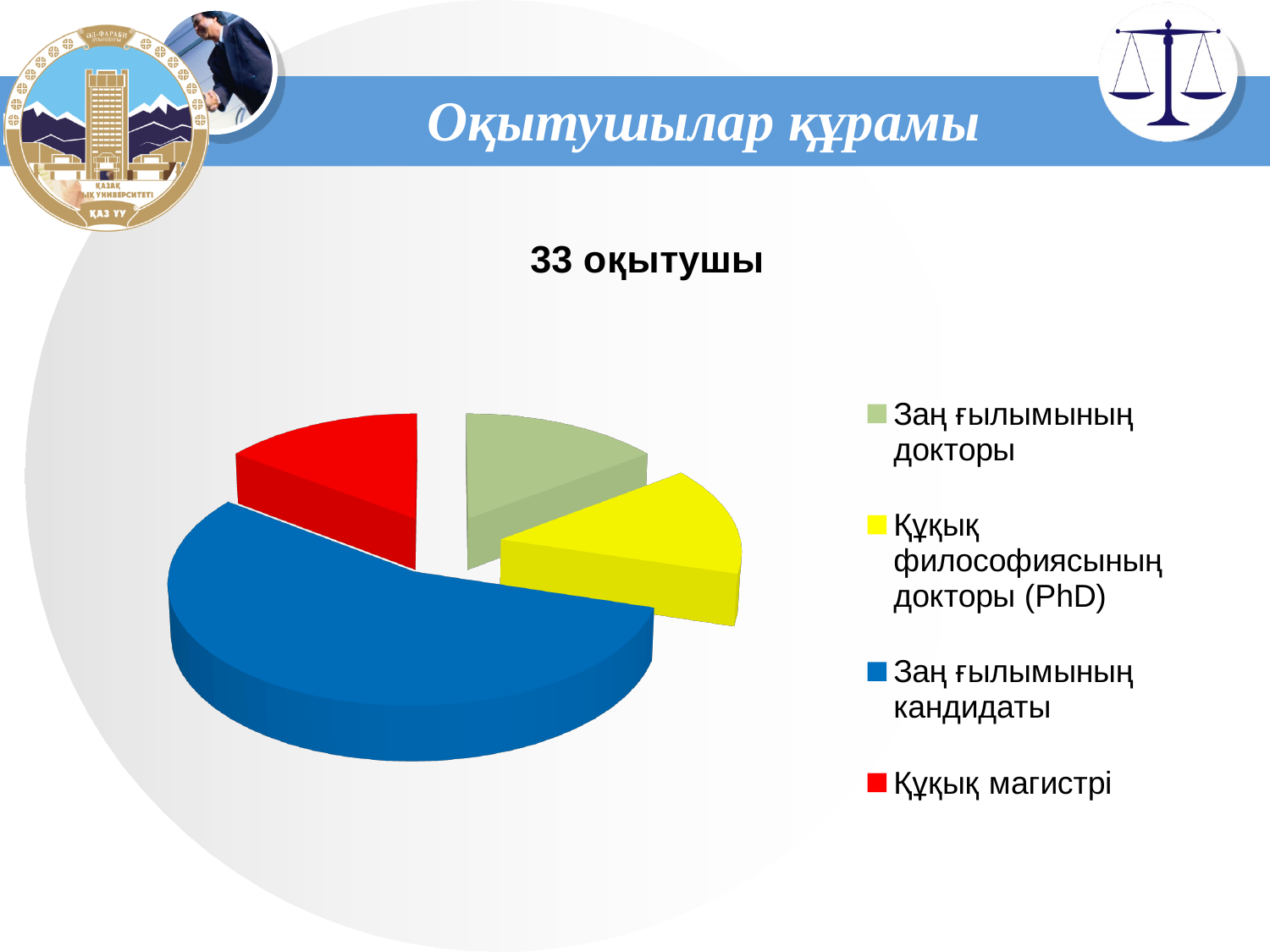
Which slice is larger: Заң ғылымының кандидаты or Құқық философиясының докторы (PhD)? Заң ғылымының кандидаты How many entries does the chart legend list? 4 Which slice is larger: Заң ғылымының кандидаты or Құқық магистрі? Заң ғылымының кандидаты How many slices does the pie chart have? 4 What kind of chart is shown on the slide? pie chart Which category has the largest slice of the pie chart? Заң ғылымының кандидаты What is the title shown above the pie chart? 33 оқытушы What colour is the slice for Құқық магистрі? red Which slice is larger: Заң ғылымының кандидаты or Заң ғылымының докторы? Заң ғылымының кандидаты